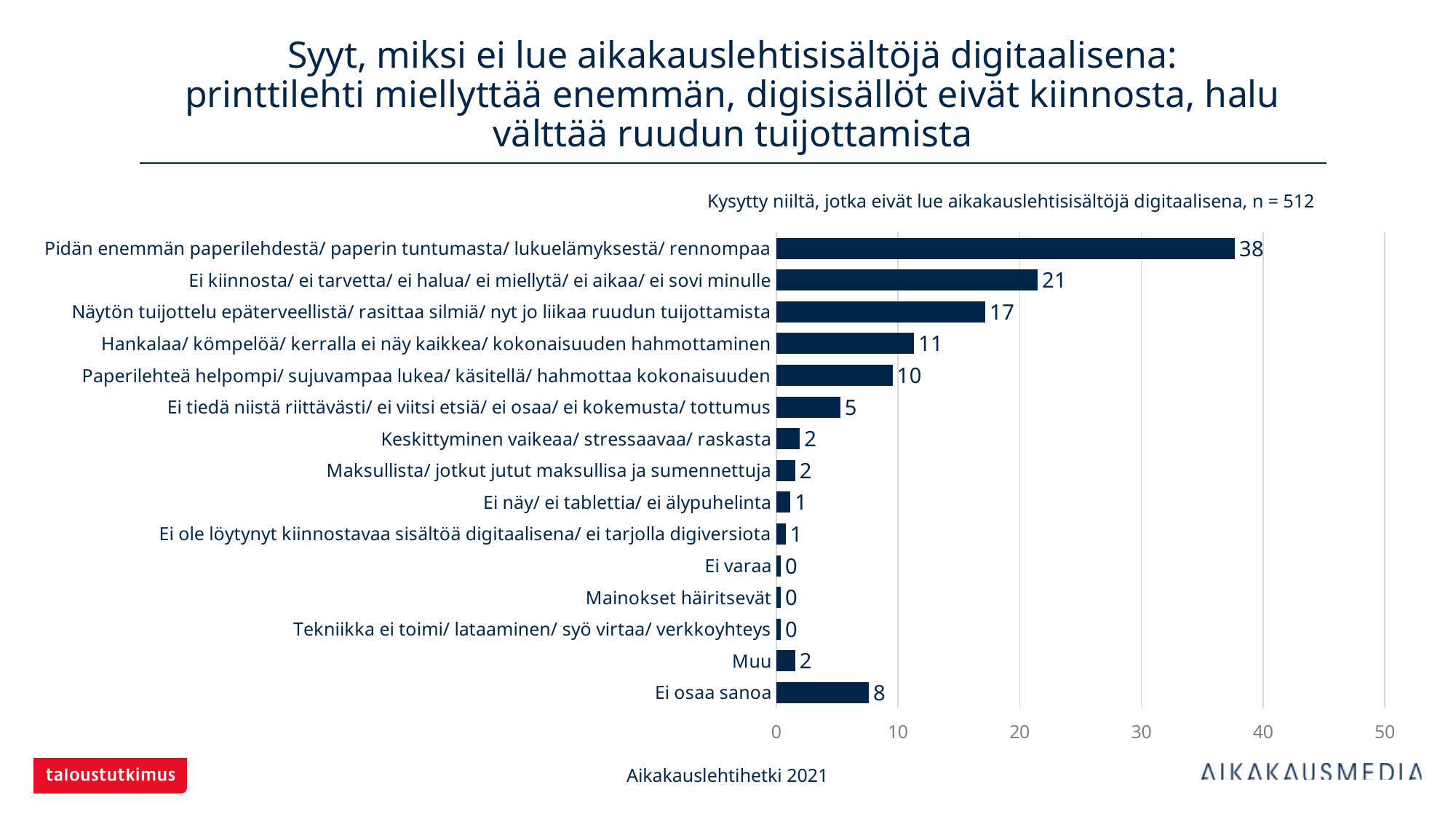
What is the difference between the values for "Pidän enemmän paperilehdestä/ paperin tuntumasta/ lukuelämyksestä/ rennompaa" and "Ei kiinnosta/ ei tarvetta/ ei halua/ ei miellytä/ ei aikaa/ ei sovi minulle"? 17 Is the value for "Pidän enemmän paperilehdestä/ paperin tuntumasta/ lukuelämyksestä/ rennompaa" greater or less than 30? greater What is the value for "Hankalaa/ kömpelöä/ kerralla ei näy kaikkea/ kokonaisuuden hahmottaminen"? 11 What is the value for "Ei osaa sanoa"? 8 What kind of chart is shown on the slide? Bar chart What is the value for "Ei kiinnosta/ ei tarvetta/ ei halua/ ei miellytä/ ei aikaa/ ei sovi minulle"? 21 What is the difference between the values for "Näytön tuijottelu epäterveellistä/ rasittaa silmiä/ nyt jo liikaa ruudun tuijottamista" and "Paperilehteä helpompi/ sujuvampaa lukea/ käsitellä/ hahmottaa kokonaisuuden"? 7 How many categories are shown in the chart? 15 Which is larger, the value for "Ei osaa sanoa" or the value for "Ei tiedä niistä riittävästi/ ei viitsi etsiä/ ei osaa/ ei kokemusta/ tottumus"? Ei osaa sanoa How many categories have a value of 0? 3 Which category has the highest value? Pidän enemmän paperilehdestä/ paperin tuntumasta/ lukuelämyksestä/ rennompaa What is the sample size (n) stated above the chart? 512